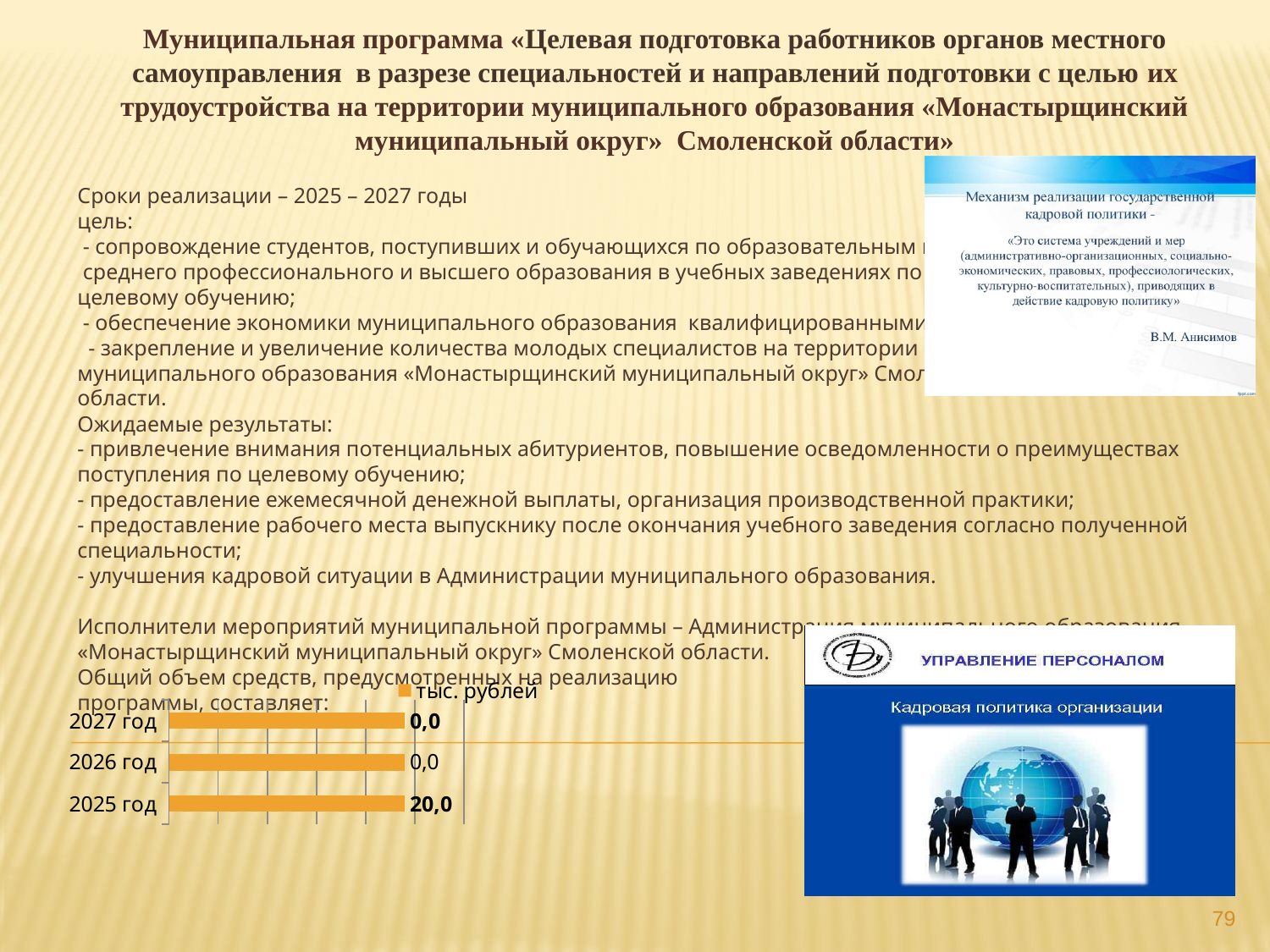
What colour are the bars in the chart? orange What value is shown for 2027 год in the bar chart? 0,0 How many years (categories) are shown in the bar chart? 3 What kind of chart is shown on the slide? bar chart How many series does the chart legend list? 1 What is the legend entry of the chart? тыс. рублей What value is shown for 2025 год in the bar chart? 20,0 What value is shown for 2026 год in the bar chart? 0,0